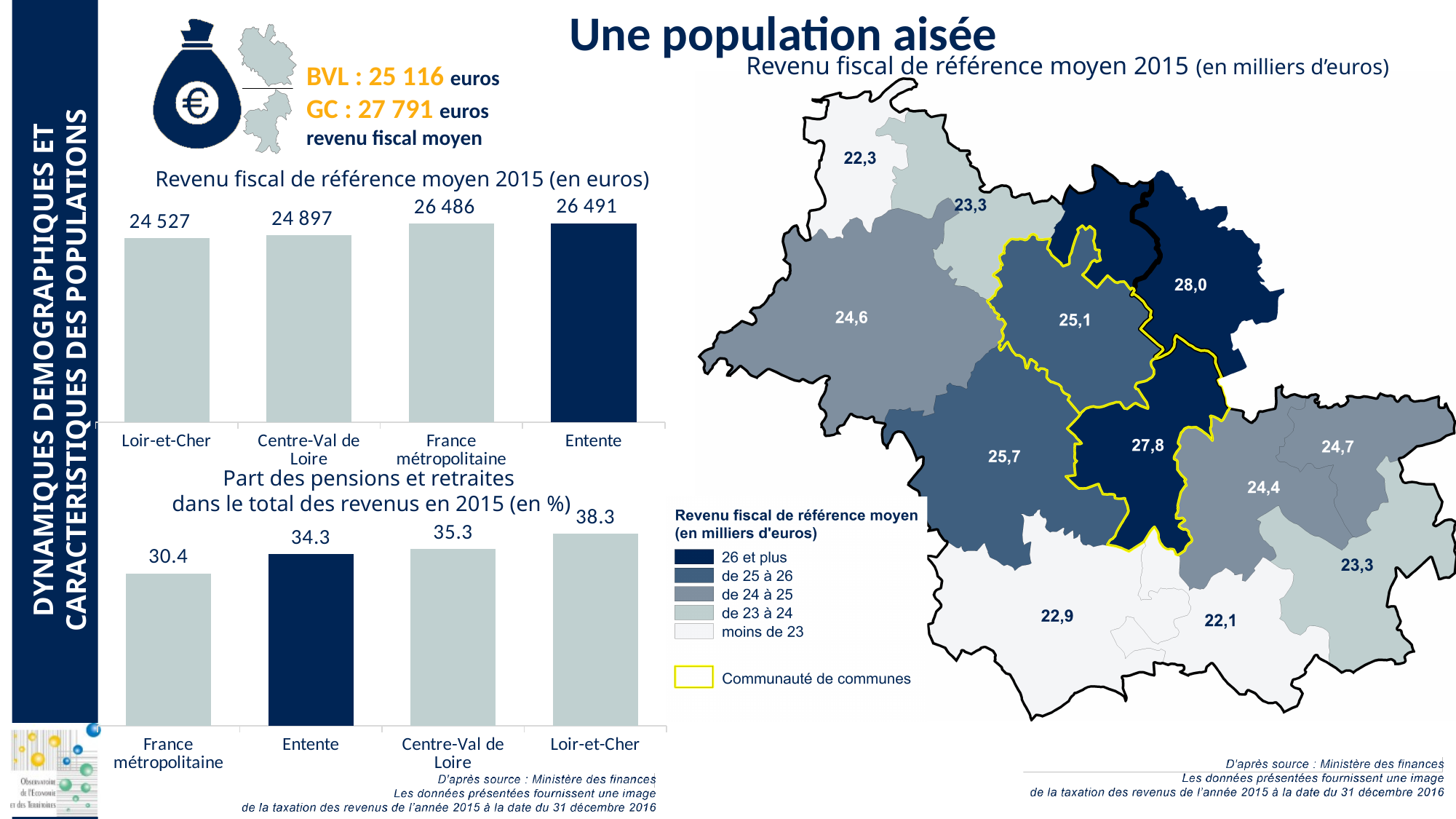
In the chart 'Part des pensions et retraites dans le total des revenus en 2015 (en %)', which category has the lowest value? France métropolitaine In the chart 'Part des pensions et retraites dans le total des revenus en 2015 (en %)', which category has the highest value? Loir-et-Cher In the chart 'Part des pensions et retraites dans le total des revenus en 2015 (en %)', is the value for Centre-Val de Loire larger or smaller than the value for Entente? larger In the chart 'Revenu fiscal de référence moyen 2015 (en euros)', which category has the lowest value? Loir-et-Cher In the chart 'Revenu fiscal de référence moyen 2015 (en euros)', what is the value for Entente? 26 491 In the chart 'Revenu fiscal de référence moyen 2015 (en euros)', how many categories are shown? 4 In the chart 'Part des pensions et retraites dans le total des revenus en 2015 (en %)', what is the value for Entente? 34.3 In the chart 'Revenu fiscal de référence moyen 2015 (en euros)', what is the value for Loir-et-Cher? 24 527 In the chart 'Part des pensions et retraites dans le total des revenus en 2015 (en %)', what is the difference between Loir-et-Cher and France métropolitaine? 7.9 In the chart 'Revenu fiscal de référence moyen 2015 (en euros)', what is the difference between Entente and Loir-et-Cher? 1 964 In the chart 'Part des pensions et retraites dans le total des revenus en 2015 (en %)', do the values rise or fall from left to right? rise What kind of chart is 'Revenu fiscal de référence moyen 2015 (en euros)'? bar chart